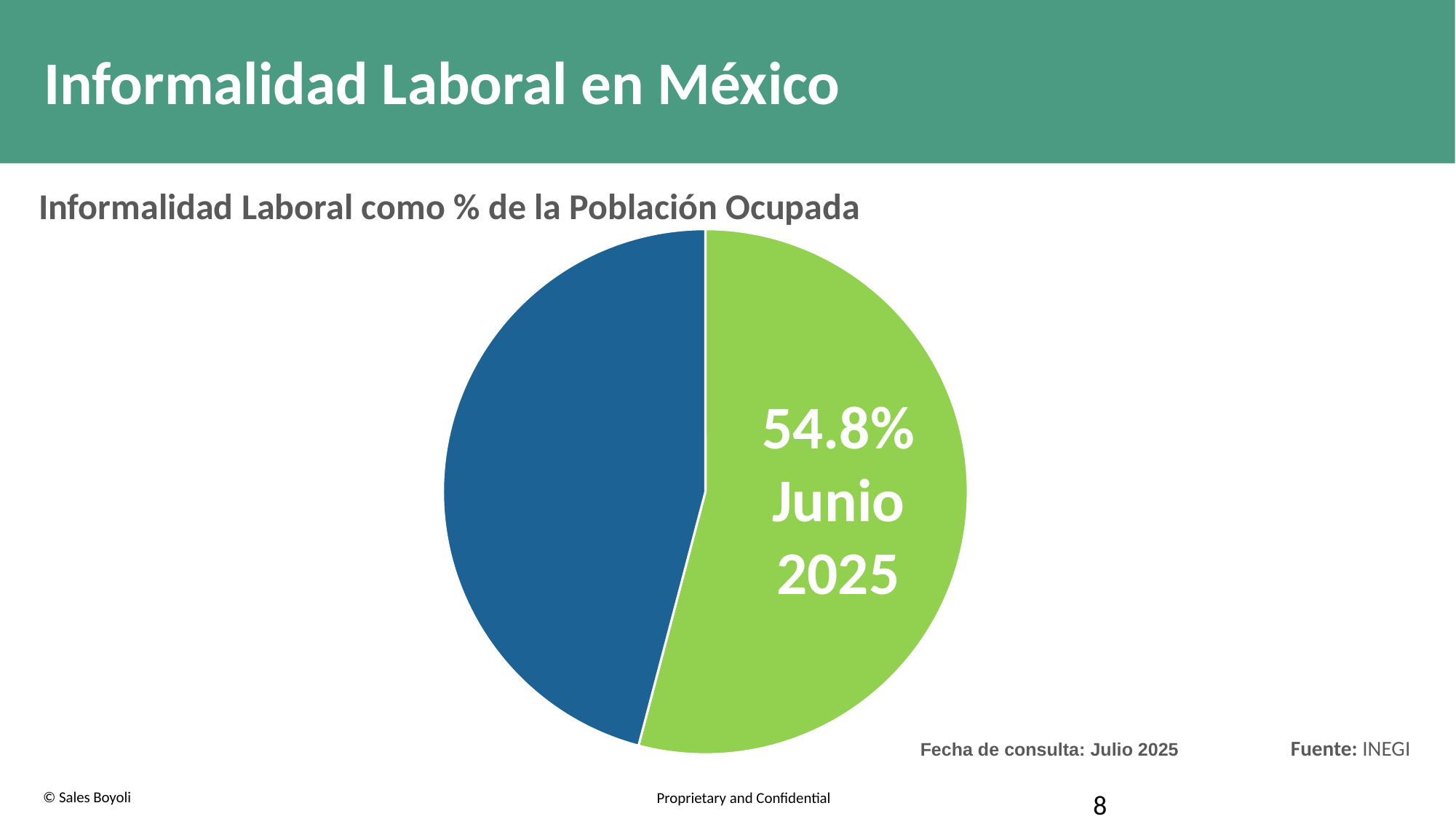
What is the title of the chart? Informalidad Laboral como % de la Población Ocupada Which month and year is labelled on the green slice? Junio 2025 What kind of chart is shown on the slide? pie chart What source is cited for the chart data? INEGI How many slices does the pie chart have? 2 What share of the pie does the green slice labelled Junio 2025 represent? 54.8% Which slice is larger, the green slice or the blue slice? green Is the value of the green slice greater or less than 50%? greater What value is printed on the green slice of the pie chart? 54.8%